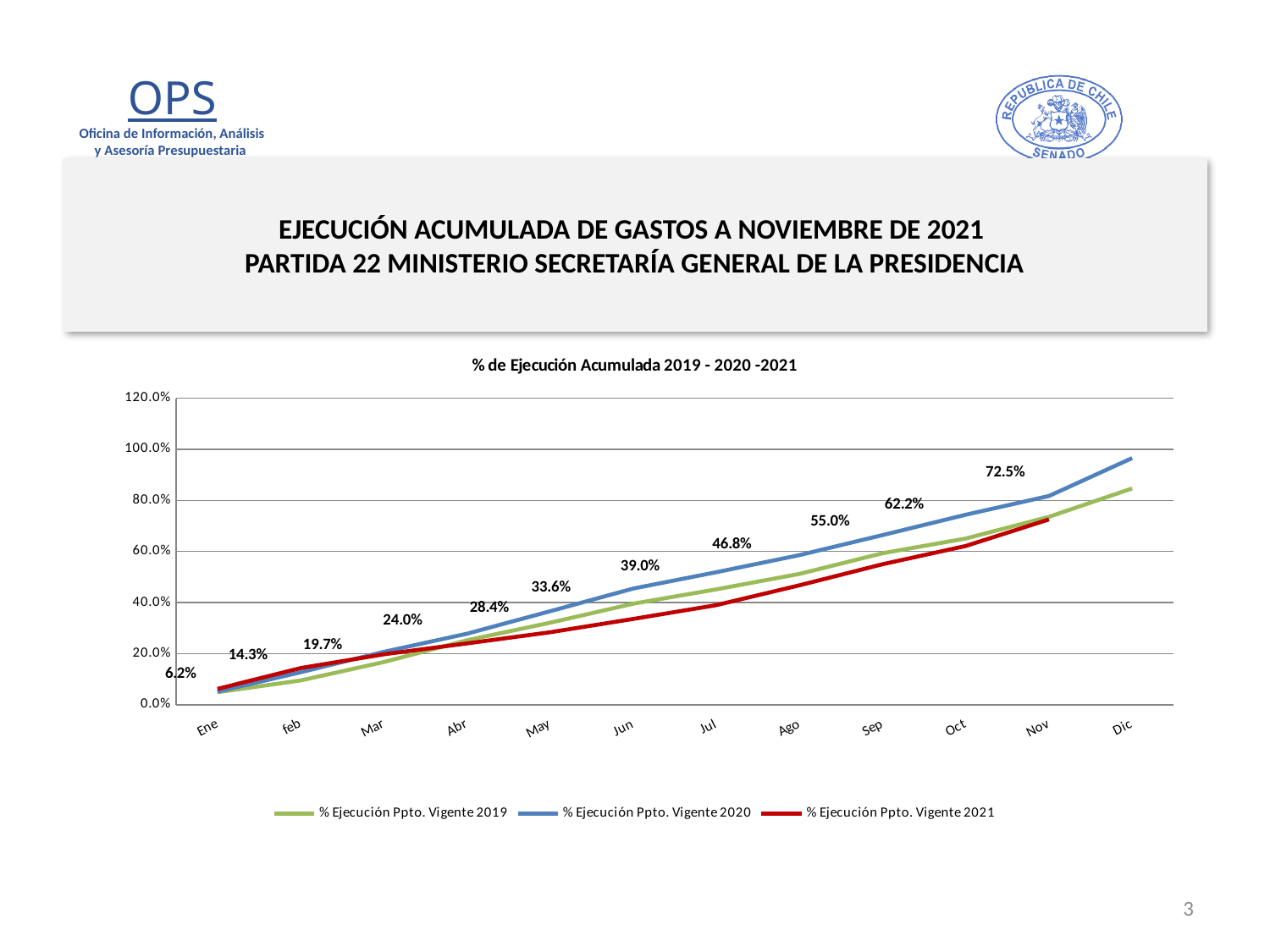
What type of chart is shown on the slide? line chart What is the labelled value for % Ejecución Ppto. Vigente 2021 in Ene? 6.2% What is the labelled value for % Ejecución Ppto. Vigente 2021 in Sep? 55.0% Do the values of the % Ejecución Ppto. Vigente 2021 series rise or fall from Ene to Nov? rise How many series does the legend list? 3 What is the labelled value for % Ejecución Ppto. Vigente 2021 in Nov? 72.5% What is the difference between the labelled 2021 values for Nov and Oct? 10.3% What is the labelled value for % Ejecución Ppto. Vigente 2021 in Jun? 33.6% What is the title of the chart? % de Ejecución Acumulada 2019 - 2020 -2021 Is the value for % Ejecución Ppto. Vigente 2020 in Dic greater or less than 80.0%? greater How many months are shown on the x axis? 12 In Dic, which series is higher: % Ejecución Ppto. Vigente 2020 or % Ejecución Ppto. Vigente 2019? % Ejecución Ppto. Vigente 2020